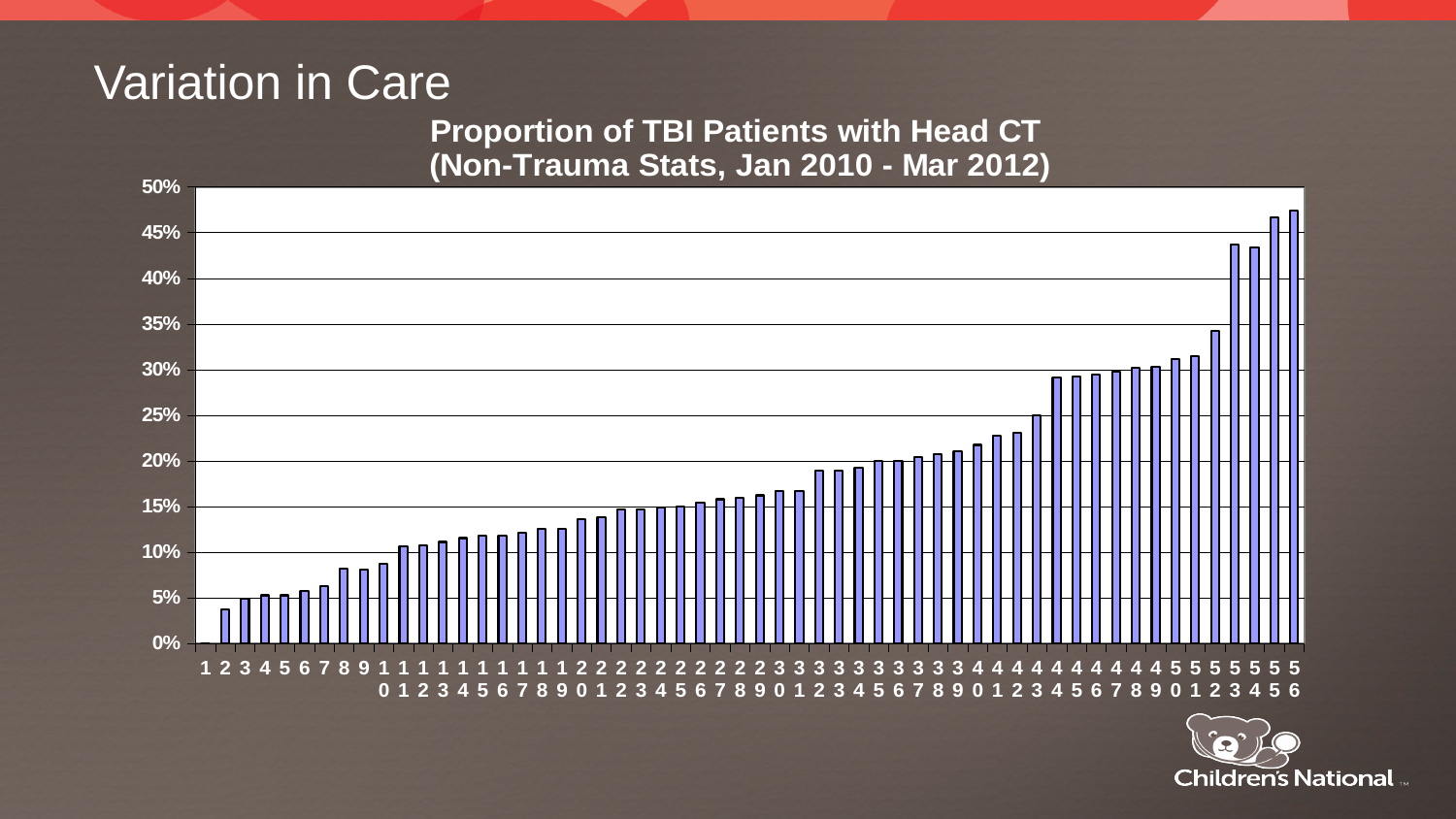
Which has the larger value, category 52 or category 53? 53 What kind of chart is shown on the slide? bar chart Is the value for category 44 greater or less than 25%? greater How many categories are plotted along the x axis of the chart? 56 Is the value for category 56 greater or less than 45%? greater What is the highest value shown on the y axis of the chart? 50% Do the bar values generally rise or fall from left to right along the x axis? rise Which category has the highest proportion of TBI patients with head CT? 56 What is the title of the chart? Proportion of TBI Patients with Head CT (Non-Trauma Stats, Jan 2010 - Mar 2012) Is the value for category 20 greater or less than 15%? less